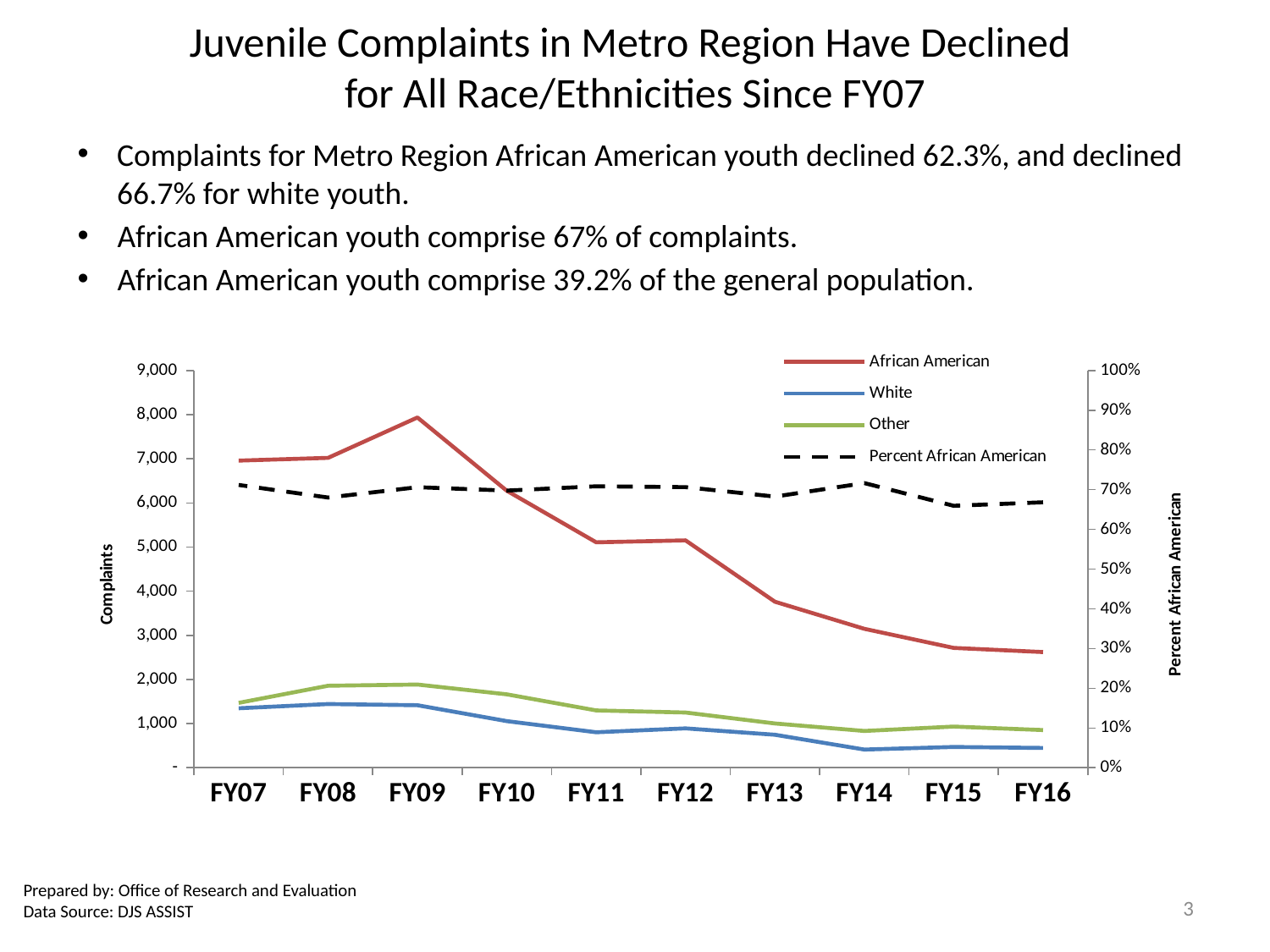
Does the African American series rise or fall from FY09 to FY16? Fall Is the value for African American complaints in FY09 greater or less than 7,000? greater In which fiscal year is the African American series at its lowest value? FY16 Which is larger in FY09, the White series or the Other series? Other Is the value for White complaints in FY07 greater or less than 1,000? greater What kind of chart is shown on the slide? Line chart In which fiscal year does the African American series reach its highest value? FY09 How many series does the chart legend list? 4 Which series is drawn as a dashed line? Percent African American How many fiscal years are plotted along the x axis? 10 Which is larger for the White series, FY13 or FY14? FY13 Is the value for African American complaints in FY16 greater or less than 3,000? less